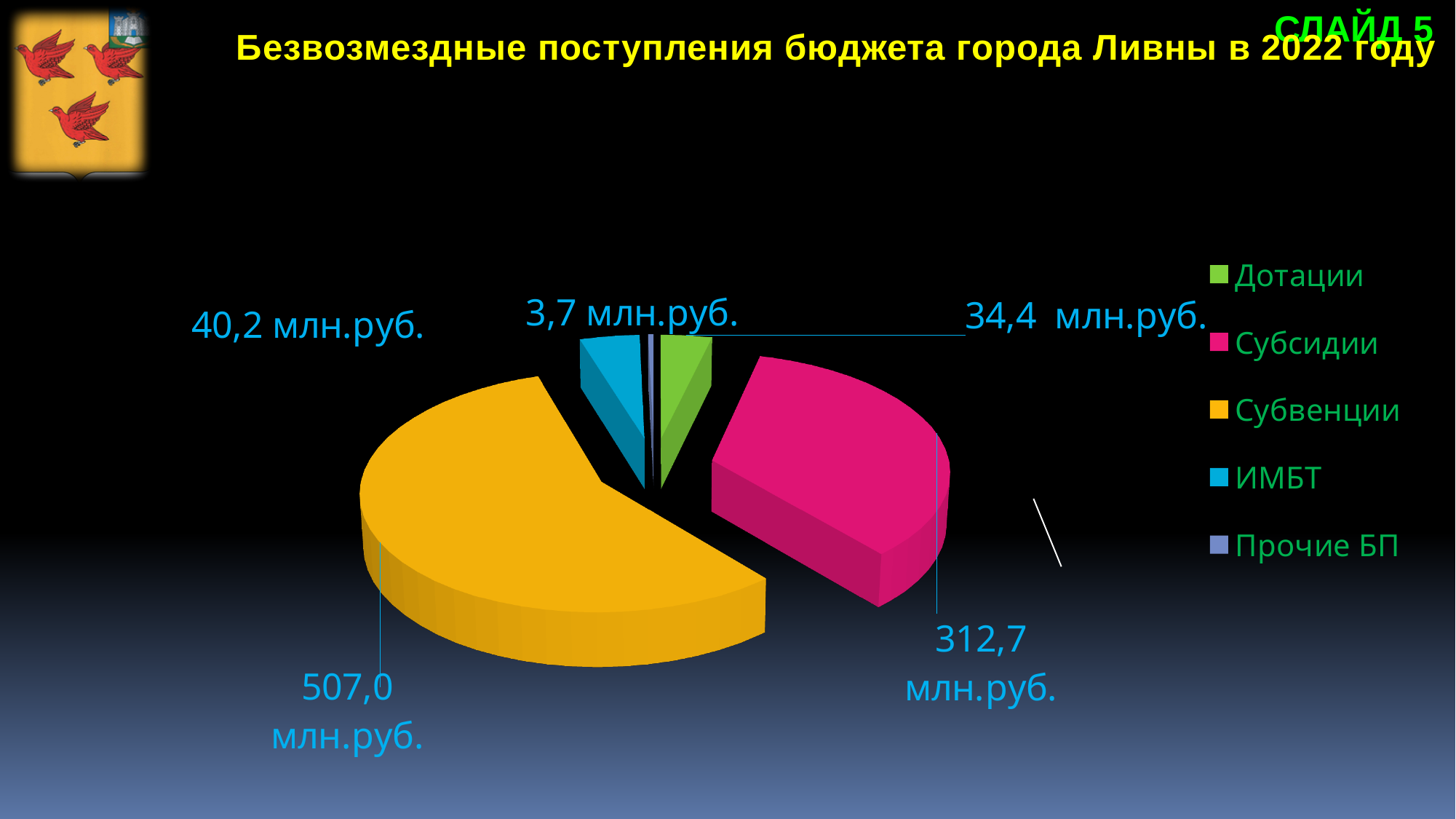
What is the title of the chart? Безвозмездные поступления бюджета города Ливны в 2022 году How many categories does the legend list? 5 What is the value for Дотации? 34,4 млн.руб. What is the value for Субсидии? 312,7 млн.руб. Which category has the smallest slice? Прочие БП Which category has the largest slice? Субвенции What type of chart is shown on the slide? Pie chart What is the value for Субвенции? 507,0 млн.руб. What is the value for Прочие БП? 3,7 млн.руб. What is the difference between Субвенции and Субсидии? 194,3 млн.руб. What is the value for ИМБТ? 40,2 млн.руб. Which is larger, ИМБТ or Дотации? ИМБТ